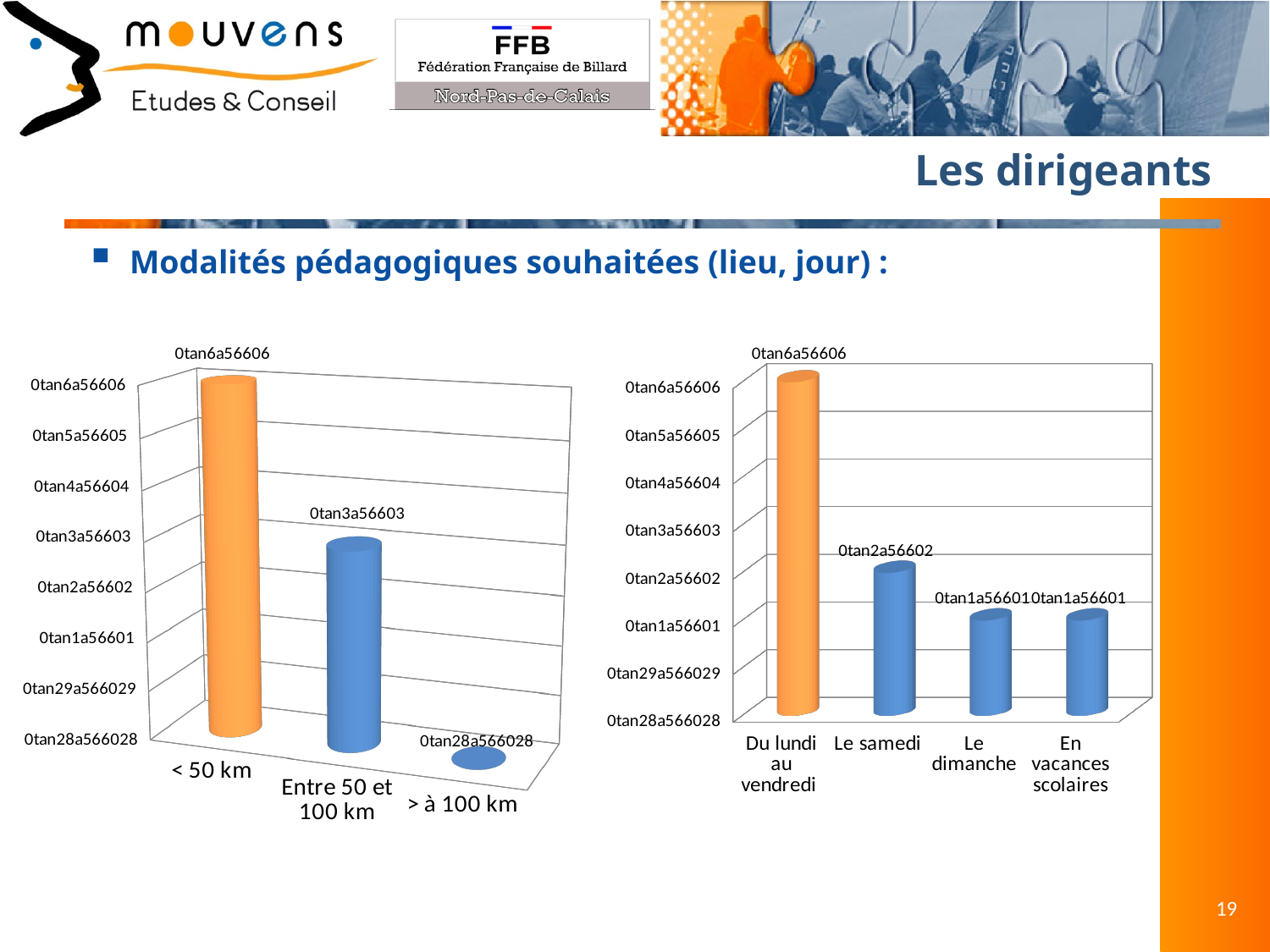
In the left chart, which category has the lowest bar? > à 100 km In the right chart, which is larger, 'Le samedi' or 'Le dimanche'? Le samedi In the right chart, which category has the highest bar? Du lundi au vendredi In the left chart, do the values rise or fall from '< 50 km' to '> à 100 km'? fall In the left chart, which category has the highest bar? < 50 km What kind of chart is the right chart? bar chart In the left chart, which is larger, '< 50 km' or 'Entre 50 et 100 km'? < 50 km In the right chart, what colour is the bar for 'Du lundi au vendredi'? orange What kind of chart is the left chart? bar chart How many categories are shown in the right chart? 4 What is the bullet heading above the two charts? Modalités pédagogiques souhaitées (lieu, jour) : How many categories are shown in the left chart? 3